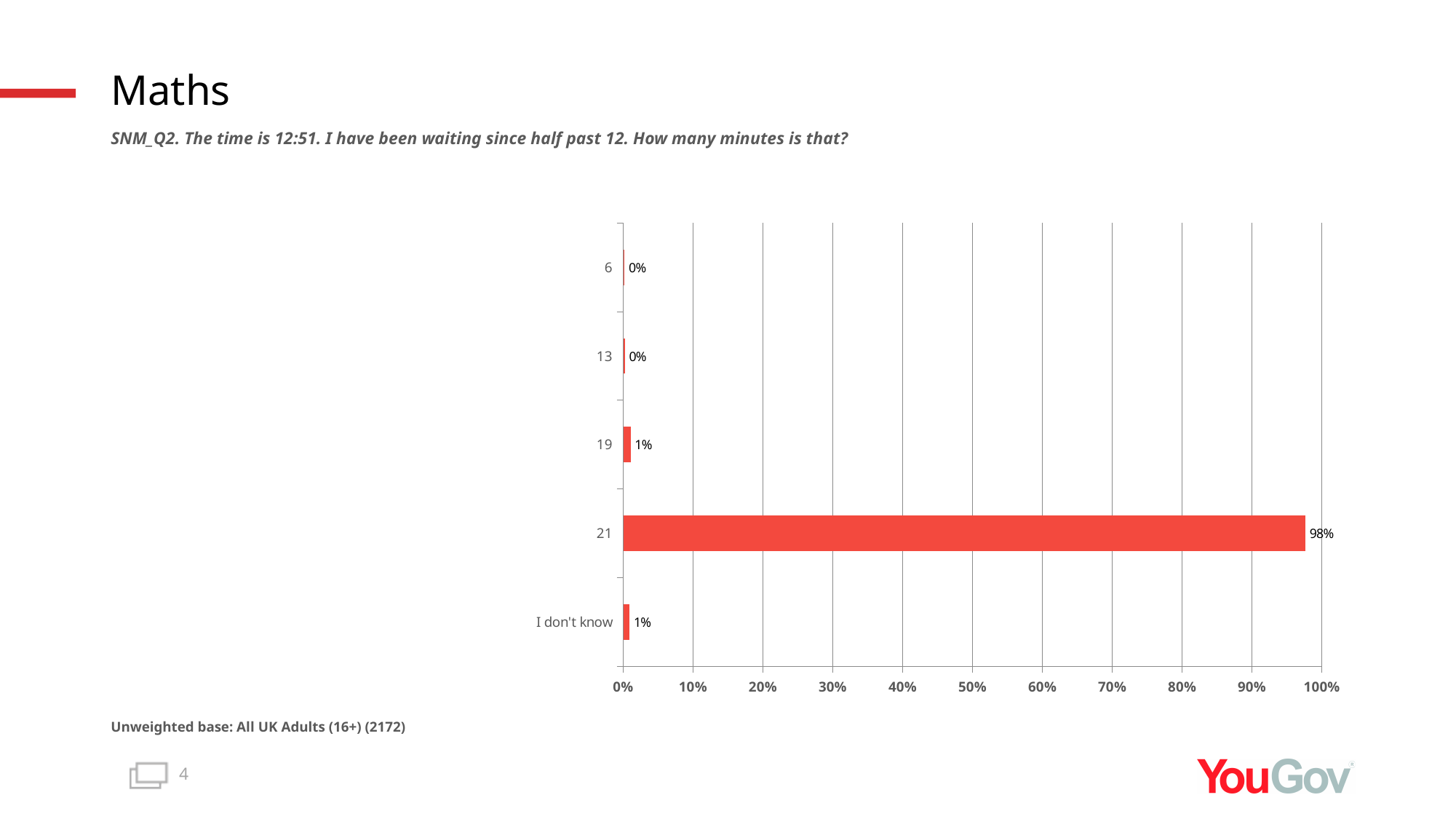
What percentage of respondents answered 6? 0% What percentage of respondents answered 21? 98% What is the difference in percentage points between the answer 21 and the answer 19? 97 What is the highest value shown on the x axis? 100% What is the unweighted base stated below the chart? All UK Adults (16+) (2172) What percentage of respondents answered 19? 1% What percentage of respondents answered 'I don't know'? 1% Which has a larger percentage, the answer 21 or the answer 13? 21 How many answer options are shown on the chart? 5 What kind of chart is shown on the slide? bar chart Is the value for the answer 21 greater or less than 90%? greater Which answer option has the highest percentage? 21